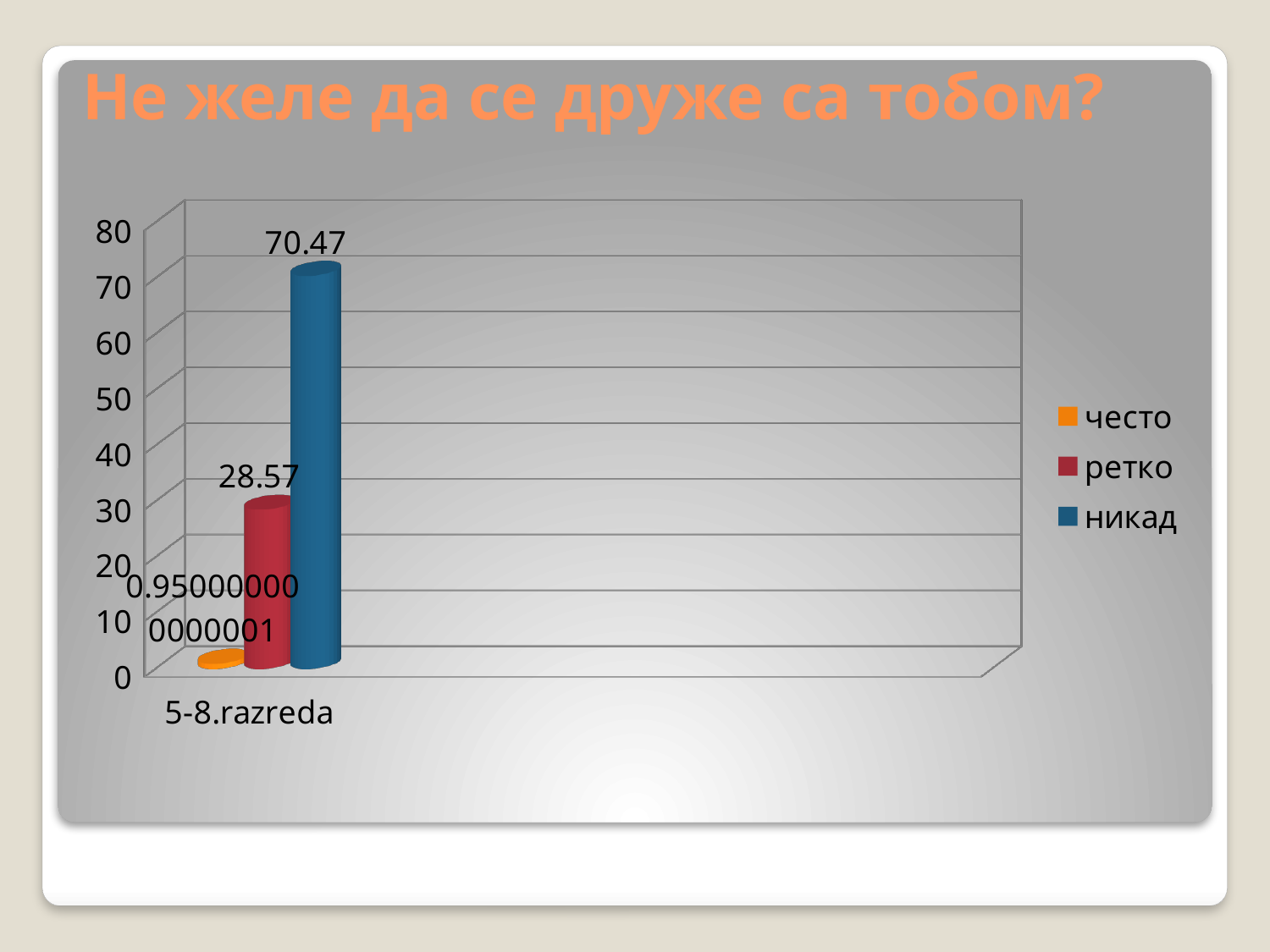
What is the value for никад in the 5-8.razreda category? 70.47 How many categories are shown on the x axis? 1 What is the value for ретко in the 5-8.razreda category? 28.57 What is the title of the chart? Не желе да се друже са тобом? Which series has the highest value for 5-8.razreda? никад Which is larger, the value for ретко or the value for никад? никад What kind of chart is shown on the slide? bar chart Is the value for никад greater or less than 60? greater What is the difference between the values for никад and ретко? 41.9 Is the value for често greater or less than 10? less How many series does the legend list? 3 Which series has the lowest value for 5-8.razreda? често